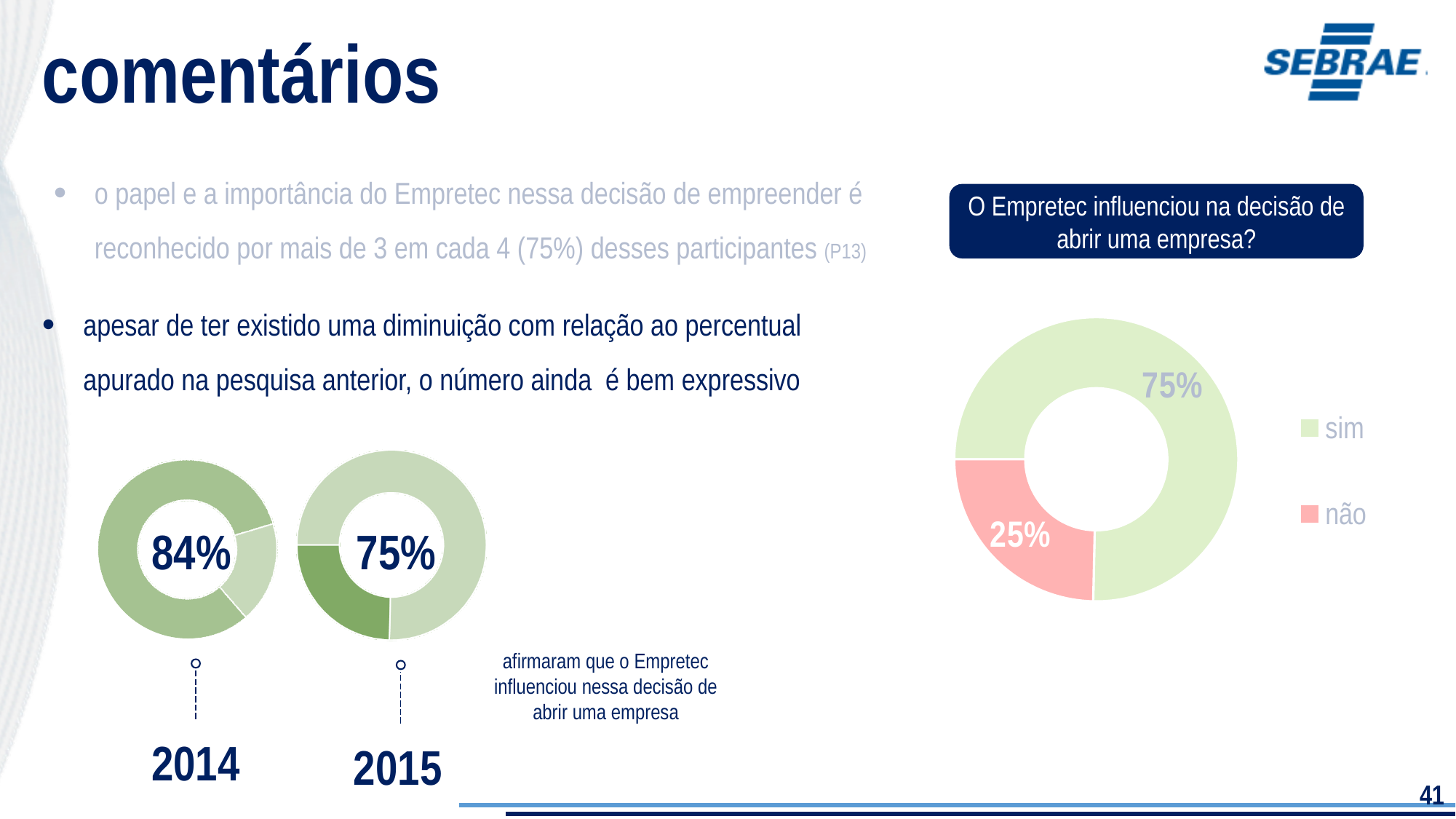
What kind of chart is the one titled "O Empretec influenciou na decisão de abrir uma empresa?"? Donut chart In the small donut charts at the bottom left, which year has the higher percentage, 2014 or 2015? 2014 In the chart titled "O Empretec influenciou na decisão de abrir uma empresa?", what percentage answered "não"? 25% In the small donut charts at the bottom left, by how many percentage points did the value fall from 2014 to 2015? 9 percentage points In the chart titled "O Empretec influenciou na decisão de abrir uma empresa?", which category has the largest share? sim In the chart titled "O Empretec influenciou na decisão de abrir uma empresa?", what colour represents "não"? Pink In the small donut charts at the bottom left, what percentage is shown for 2014? 84% In the chart titled "O Empretec influenciou na decisão de abrir uma empresa?", what percentage answered "sim"? 75% In the chart titled "O Empretec influenciou na decisão de abrir uma empresa?", what is the difference between the "sim" and "não" shares? 50% How many entries does the legend of the chart titled "O Empretec influenciou na decisão de abrir uma empresa?" list? 2 In the chart titled "O Empretec influenciou na decisão de abrir uma empresa?", which category has the smallest share? não In the small donut charts at the bottom left, what percentage is shown for 2015? 75%